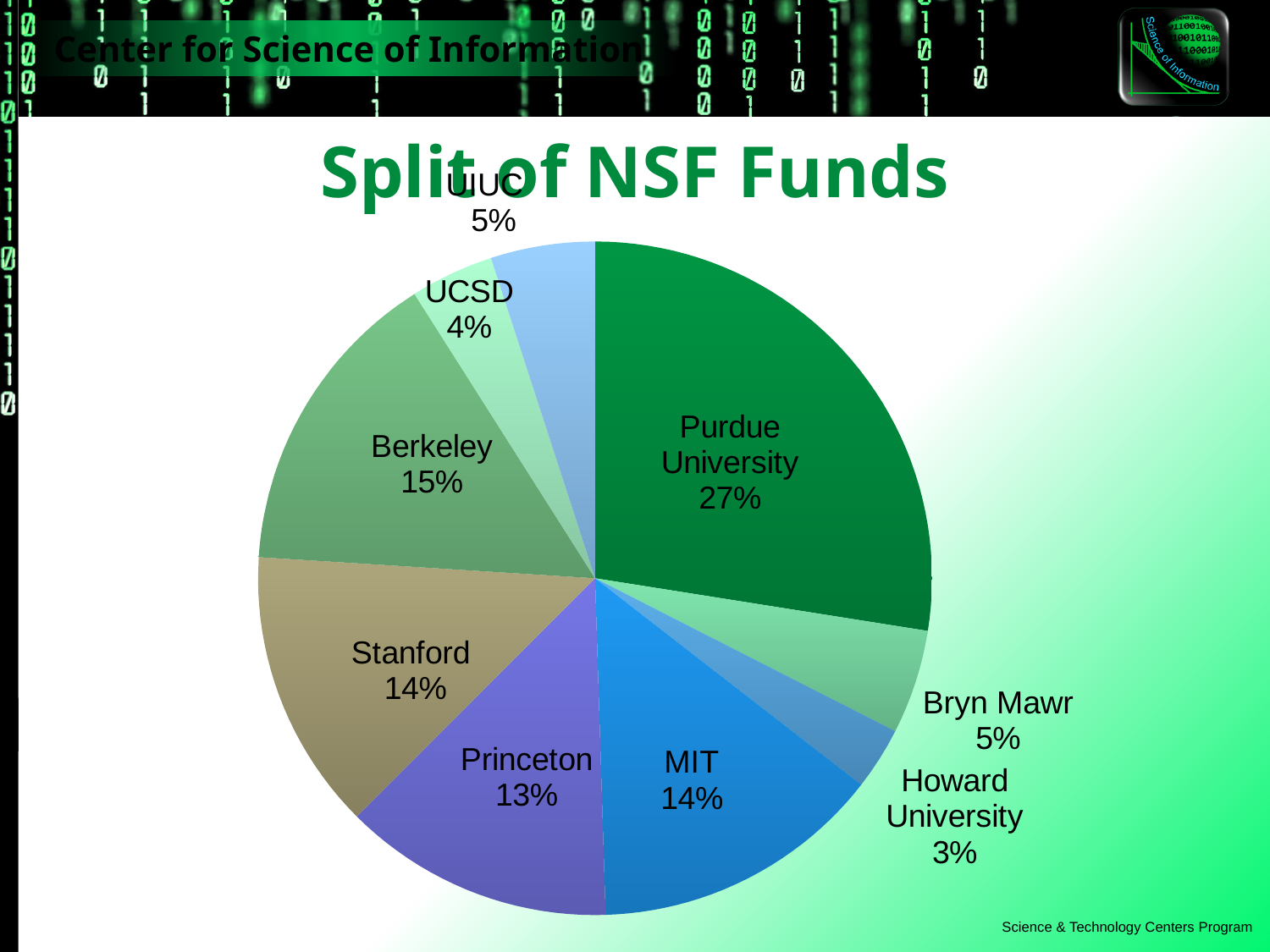
Which institution receives the largest share of NSF funds? Purdue University What share of NSF funds goes to Princeton? 13% How many institutions are shown in the pie chart? 9 What share of NSF funds goes to Berkeley? 15% What is the title of the chart? Split of NSF Funds What is the combined share of UCSD and UIUC? 9% Which receives a larger share of NSF funds, Stanford or Princeton? Stanford What kind of chart is shown on the slide? pie chart What is the difference in percentage points between Purdue University's share and Berkeley's share? 12 What share of NSF funds goes to Howard University? 3% What share of NSF funds goes to Purdue University? 27% Which institution receives the smallest share of NSF funds? Howard University